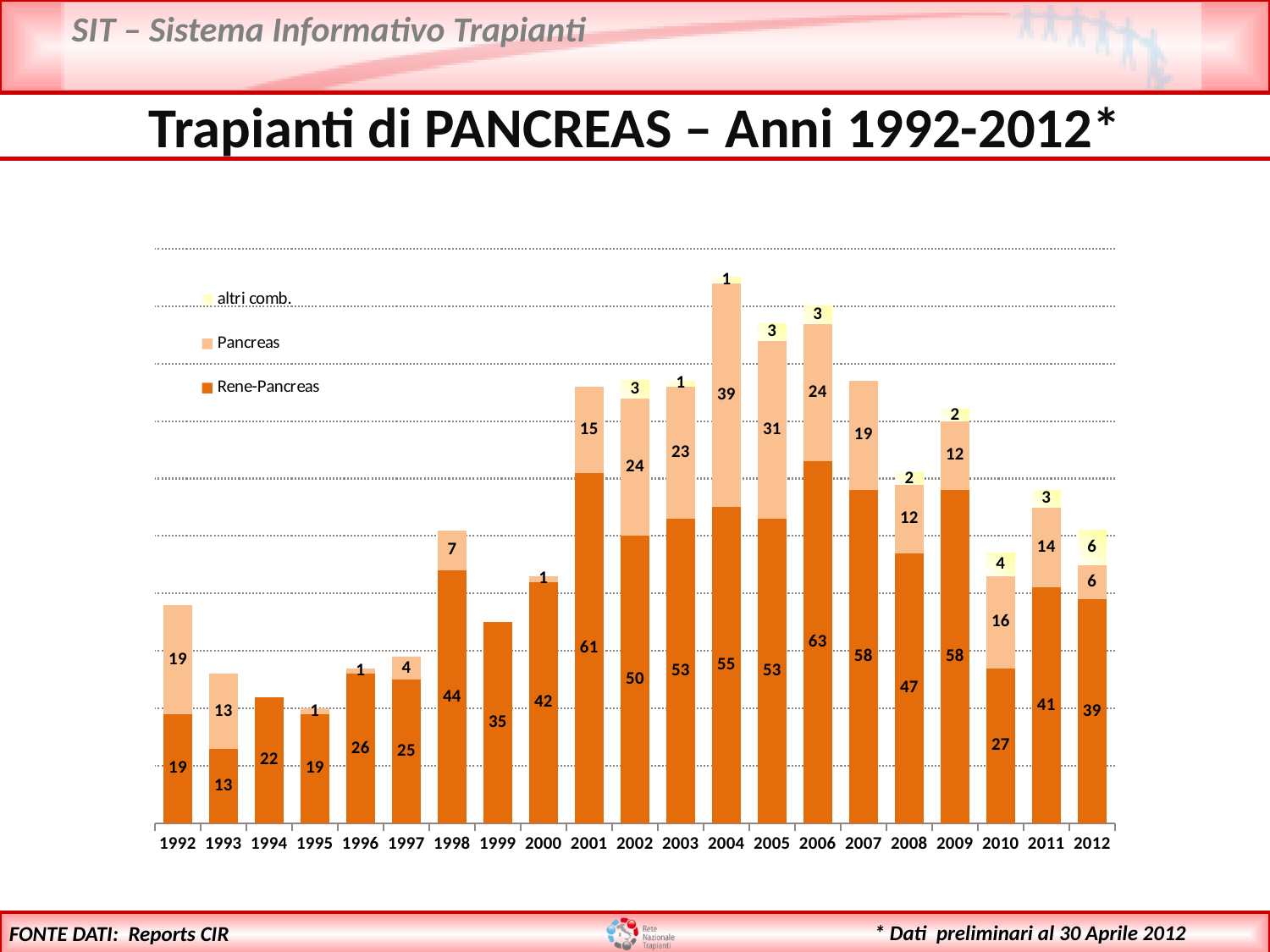
What is the Pancreas value for 2004? 39 How many years are shown on the x axis? 21 Which is larger, the Pancreas value for 2005 or the Pancreas value for 2007? 2005 What is the title of the chart? Trapianti di PANCREAS – Anni 1992-2012* Which year has the highest Rene-Pancreas value? 2006 What is the Rene-Pancreas value for 2006? 63 Which year has the lowest Rene-Pancreas value? 1993 What is the total of the stacked bar for 2004? 95 What type of chart is shown on the slide? stacked bar chart What is the altri comb. value for 2012? 6 What is the difference between the Rene-Pancreas values for 2009 and 2010? 31 How many series does the legend list? 3